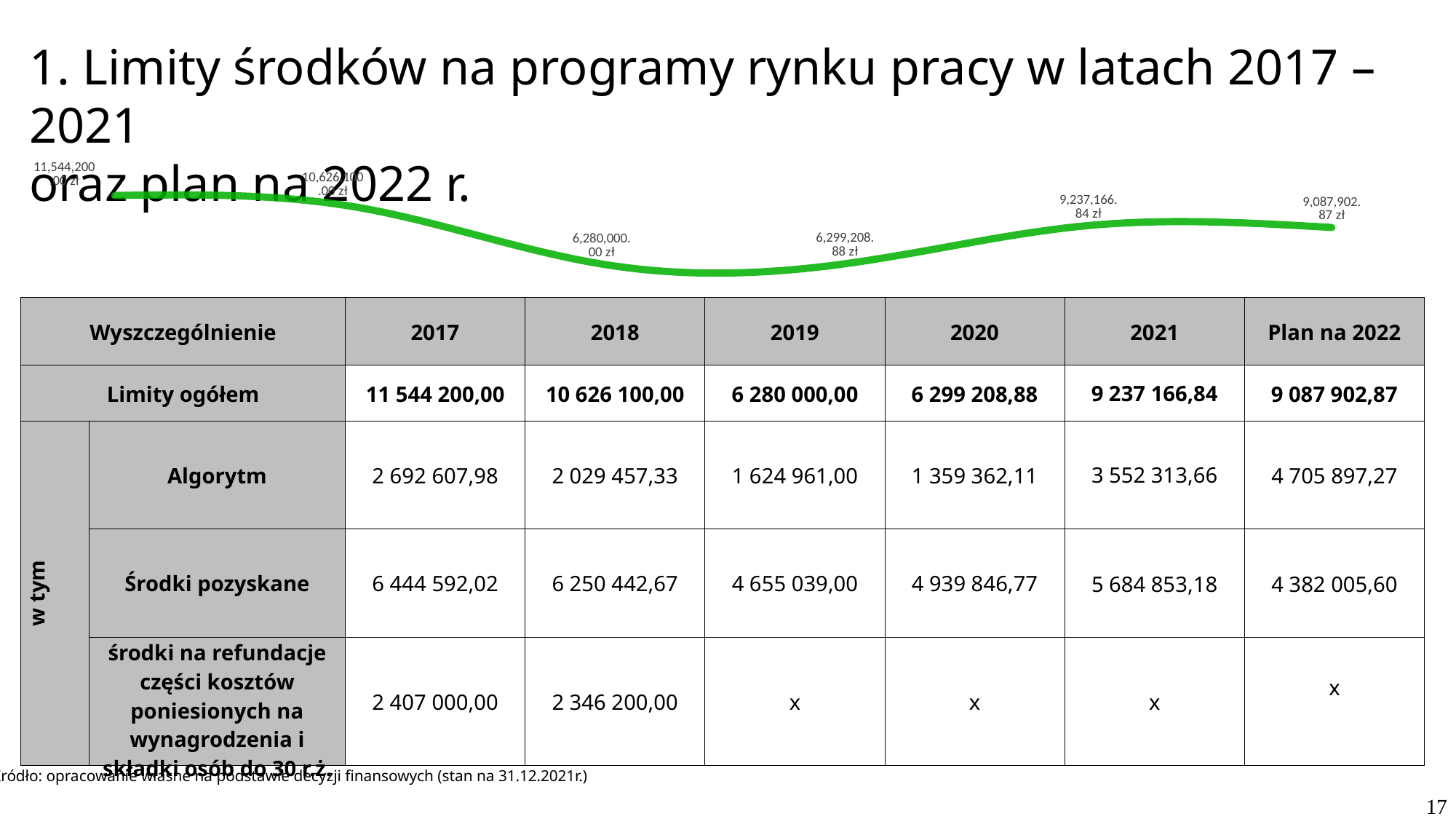
How many data points are plotted on the line chart? 6 What value does the line chart's data label show for the last point (Plan na 2022)? 9,087,902.87 zł Which point on the line chart has the highest value? 2017 (11,544,200.00 zł) What value does the line chart's data label show for the fifth point (2021)? 9,237,166.84 zł What value does the line chart's data label show for the third point (2019)? 6,280,000.00 zł What value does the line chart's data label show for the fourth point (2020)? 6,299,208.88 zł Does the line on the chart rise or fall between the first point (2017) and the third point (2019)? fall What is the difference between the 2021 value and the Plan na 2022 value on the line chart? 149,263.97 zł What colour is the line on the chart? green On the line chart, is the value for 2021 larger or smaller than the value for Plan na 2022? larger What kind of chart is shown above the table on the slide? line chart Which point on the line chart has the lowest value? 2019 (6,280,000.00 zł)